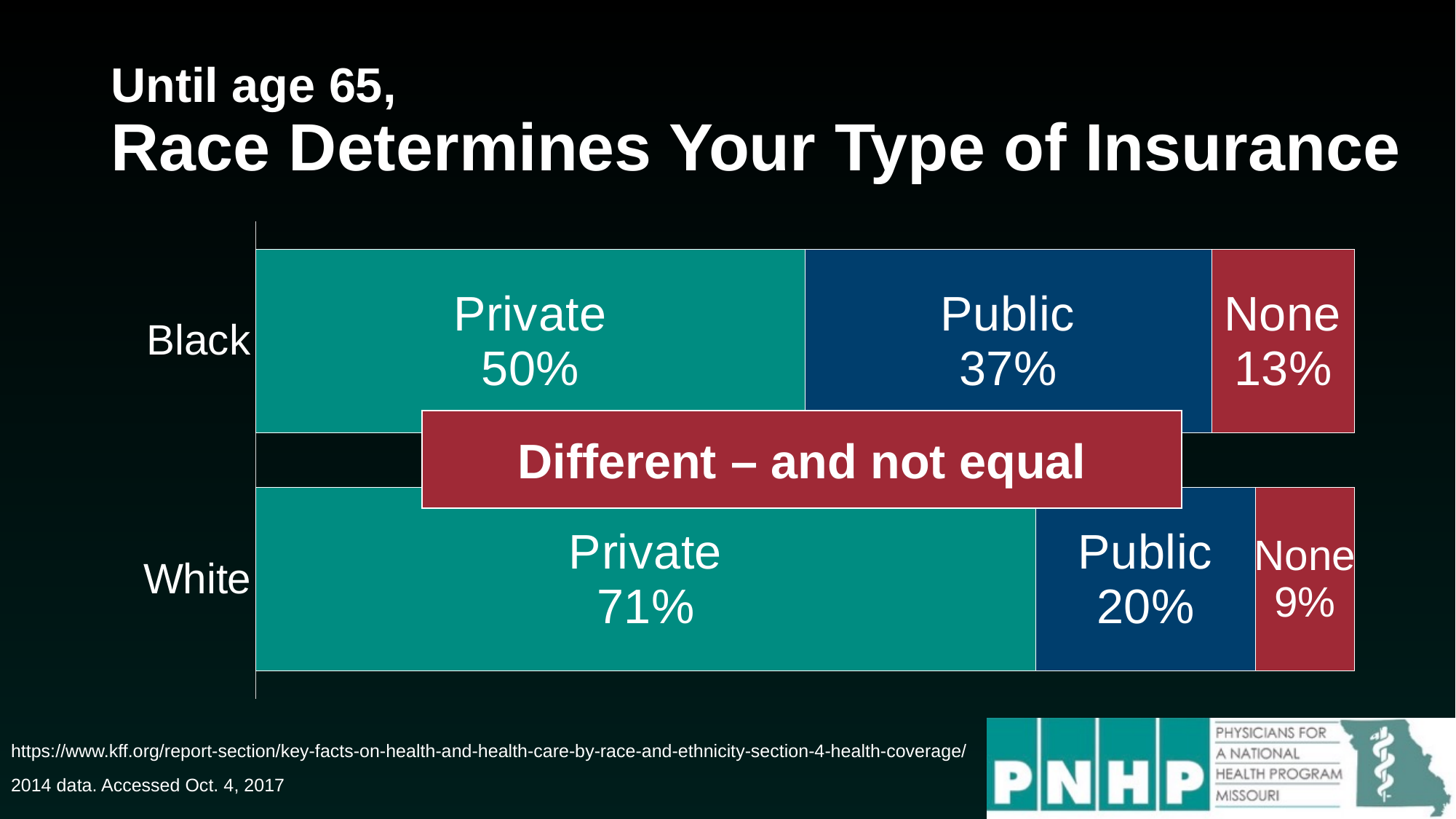
What kind of chart is shown on the slide? Stacked bar chart What is the total of the three segments in the Black bar? 100% Which insurance type has the largest share for the White group? Private Which group has the higher share of public insurance, Black or White? Black What is the difference in the uninsured share between Black and White people? 4% What is the difference in private insurance coverage between White and Black people? 21% What percentage of White people under 65 have public insurance? 20% Which insurance type has the smallest share for the Black group? None What percentage of Black people under 65 have no insurance? 13% How many racial groups are shown in the chart? 2 What percentage of Black people under 65 have private insurance? 50% What percentage of White people under 65 have private insurance? 71%